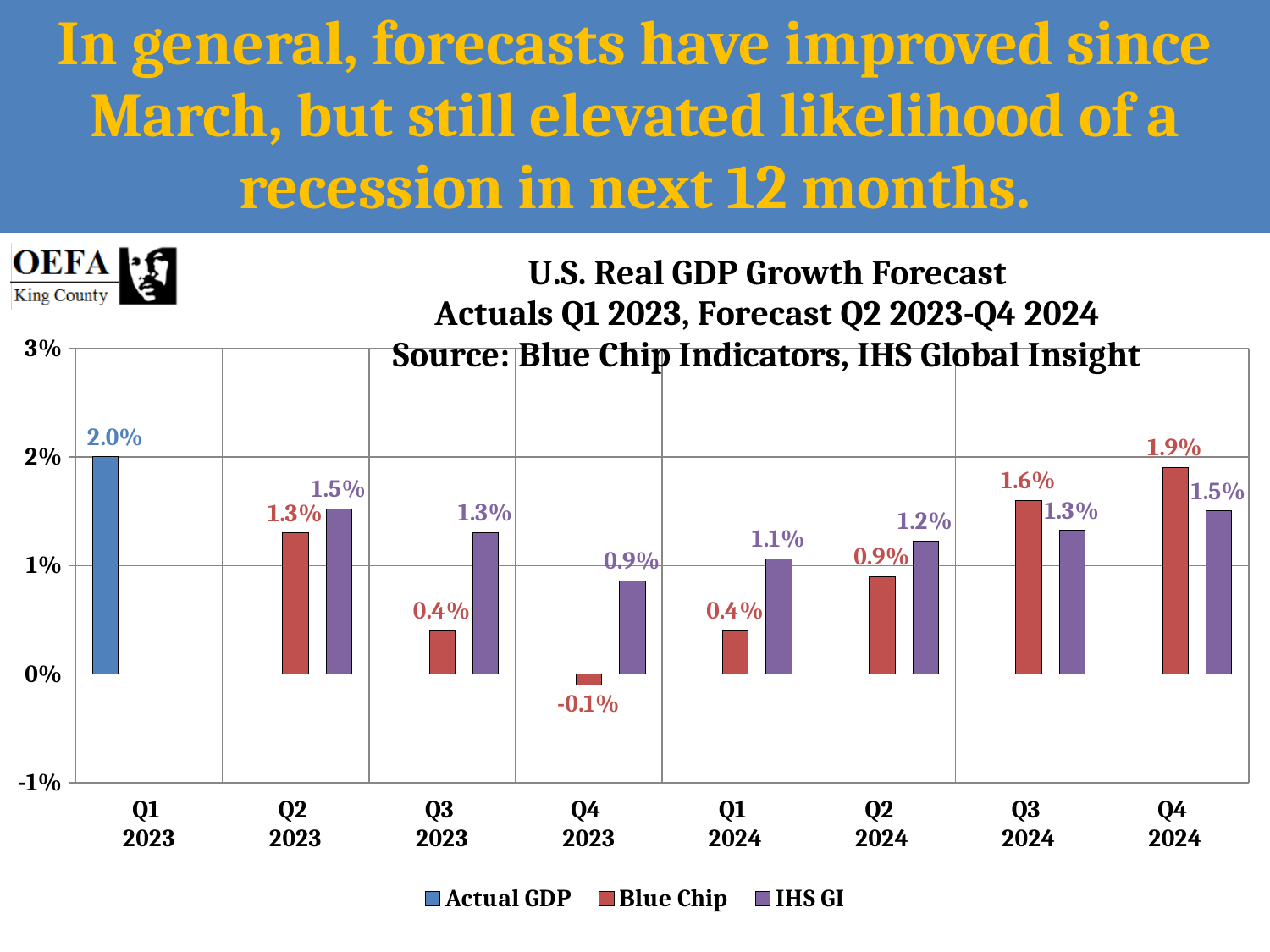
How many quarters are shown on the x axis? 8 How many series does the legend list? 3 For Q3 2024, which is larger: the Blue Chip forecast or the IHS GI forecast? Blue Chip What is the title of the chart? U.S. Real GDP Growth Forecast What is the IHS GI forecast for Q2 2024? 1.2% Which quarter has the highest Blue Chip forecast value? Q4 2024 What is the Blue Chip forecast for Q4 2023? -0.1% What is the difference between the IHS GI and Blue Chip forecasts for Q3 2023? 0.9% Do the Blue Chip forecast values rise or fall from Q4 2023 to Q4 2024? Rise Which quarter has the lowest IHS GI forecast value? Q4 2023 What is the Actual GDP value for Q1 2023? 2.0% What kind of chart is shown on the slide? Bar chart